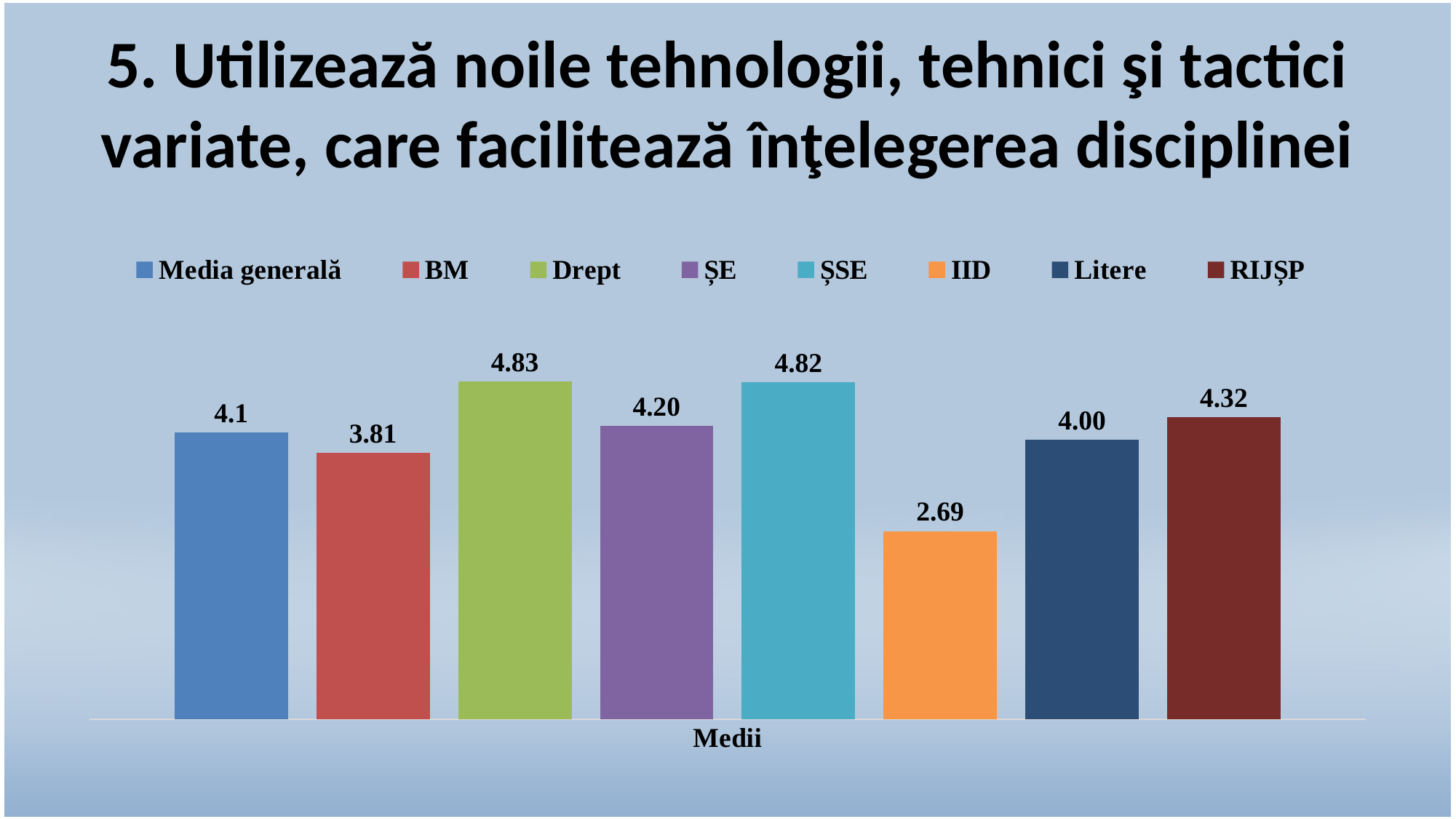
What is the difference between the values for RIJȘP and Litere? 0.32 What is the value for RIJȘP? 4.32 What is the difference between the values for Drept and IID? 2.14 Which is larger, the value for BM or the value for Litere? Litere Which series has the lowest value? IID What is the label on the x axis under the bars? Medii What kind of chart is shown on the slide? Bar chart How many series does the legend list? 8 What is the value for Media generală? 4.1 What is the value for Drept? 4.83 What is the value for IID? 2.69 Which is larger, the value for RIJȘP or the value for ȘE? RIJȘP